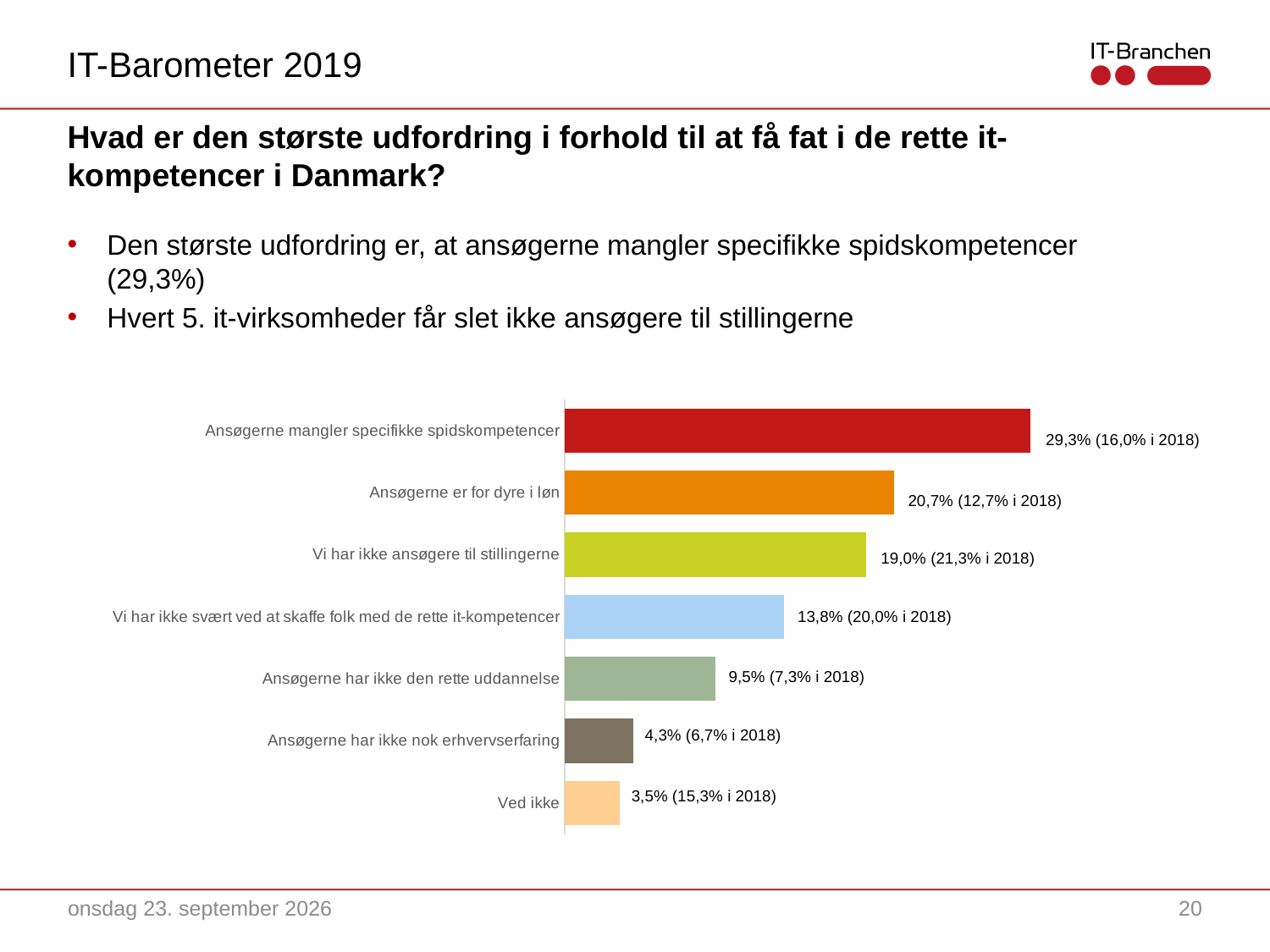
What kind of chart is shown on the slide? Bar chart What was the 2018 value shown in parentheses for "Ved ikke"? 15,3% Which is larger: the value for "Ansøgerne har ikke den rette uddannelse" or the value for "Ansøgerne har ikke nok erhvervserfaring"? Ansøgerne har ikke den rette uddannelse Do the bar values increase or decrease going from the top category to the bottom category? Decrease How many categories are shown in the bar chart? 7 What is the value shown for "Ansøgerne mangler specifikke spidskompetencer" in the bar chart? 29,3% What is the 2018 value shown in parentheses for "Vi har ikke ansøgere til stillingerne"? 21,3% What is the difference in percentage points between "Ansøgerne mangler specifikke spidskompetencer" (29,3%) and "Ansøgerne er for dyre i løn" (20,7%)? 8,6 percentage points Which category has the lowest value in the bar chart? Ved ikke What is the 2019 value shown for "Ansøgerne er for dyre i løn"? 20,7% Which category has the highest value in the bar chart? Ansøgerne mangler specifikke spidskompetencer By how many percentage points did the "Ved ikke" value fall from 2018 (15,3%) to 2019 (3,5%)? 11,8 percentage points